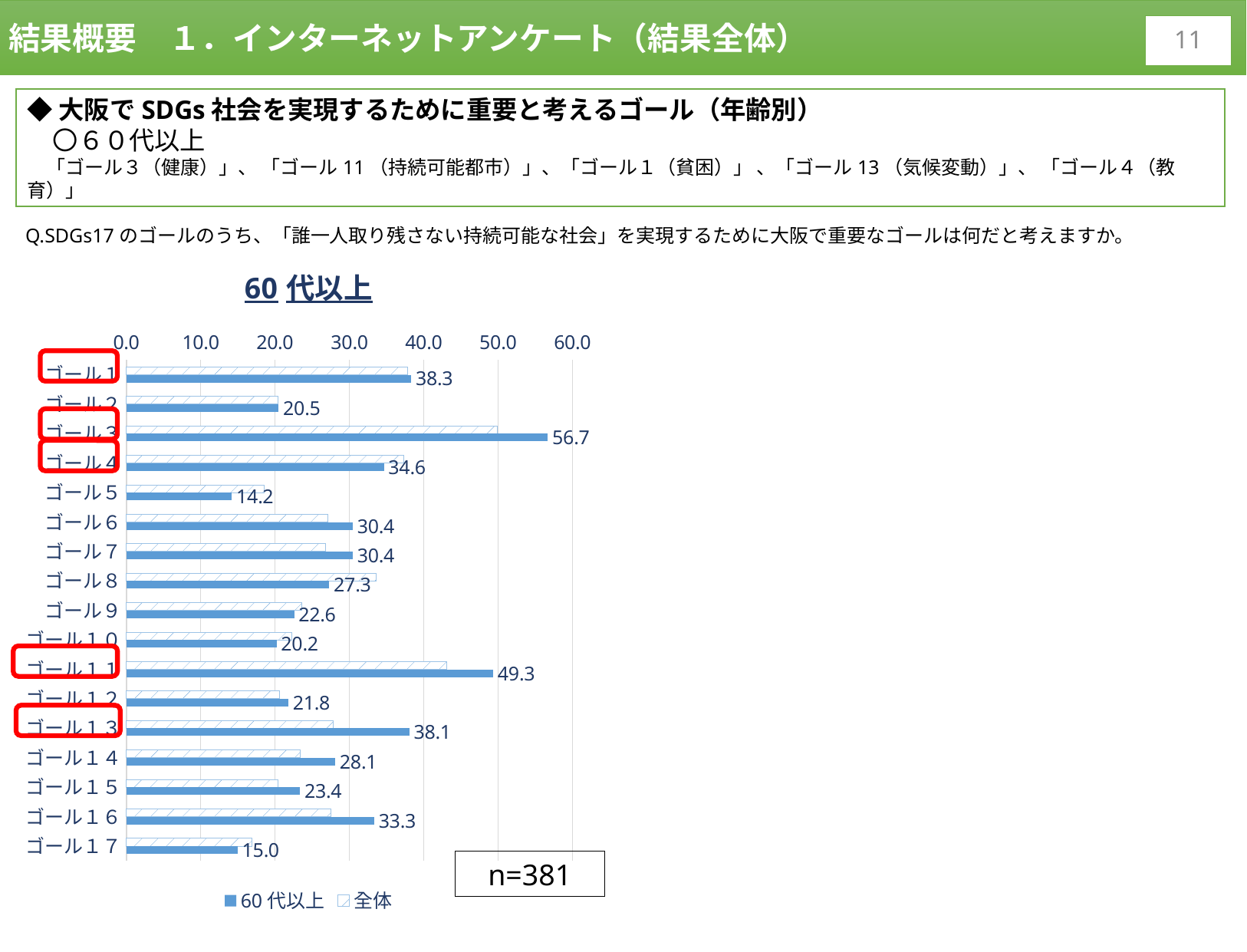
What is the value for ゴール17 in the 60代以上 series? 15.0 How many series does the legend list? 2 What is the value for ゴール11 in the 60代以上 series? 49.3 Is the 全体 value for ゴール3 greater or less than 40.0? greater What is the sample size (n) shown on the chart? n=381 What kind of chart is shown on the slide? bar chart Which goal has the lowest value in the 60代以上 series? ゴール5 What is the difference between the 60代以上 values for ゴール3 and ゴール11? 7.4 What is the value for ゴール3 in the 60代以上 series? 56.7 In the 60代以上 series, which is larger: ゴール1 or ゴール13? ゴール1 How many goal categories are plotted on the chart? 17 Which goal has the highest value in the 60代以上 series? ゴール3